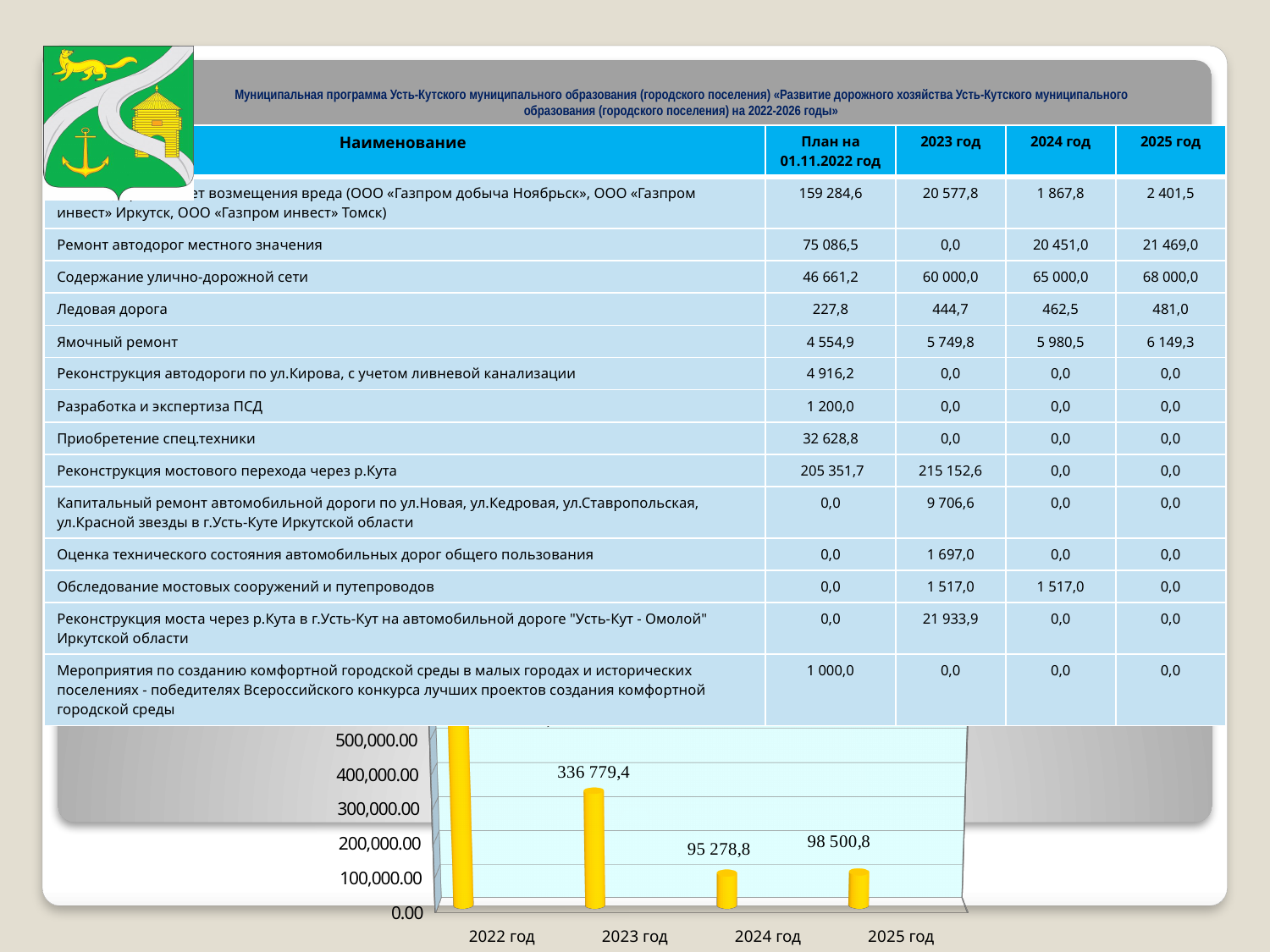
How many year categories are shown on the x axis of the bar chart? 4 What type of chart is shown at the bottom of the slide? bar chart What is the value shown for 2025 год in the bar chart? 98 500,8 Is the value for 2022 год in the bar chart greater or less than 400,000.00? greater What is the difference between the values for 2025 год and 2024 год in the bar chart? 3 222,0 In the bar chart, which is larger: the value for 2024 год or 2025 год? 2025 год Which year has the highest bar in the bar chart? 2022 год What is the difference between the values for 2023 год and 2024 год in the bar chart? 241 500,6 What is the value shown for 2024 год in the bar chart? 95 278,8 What is the value shown for 2023 год in the bar chart? 336 779,4 Which year has the lowest value in the bar chart? 2024 год Does the value in the bar chart rise or fall from 2023 год to 2024 год? fall